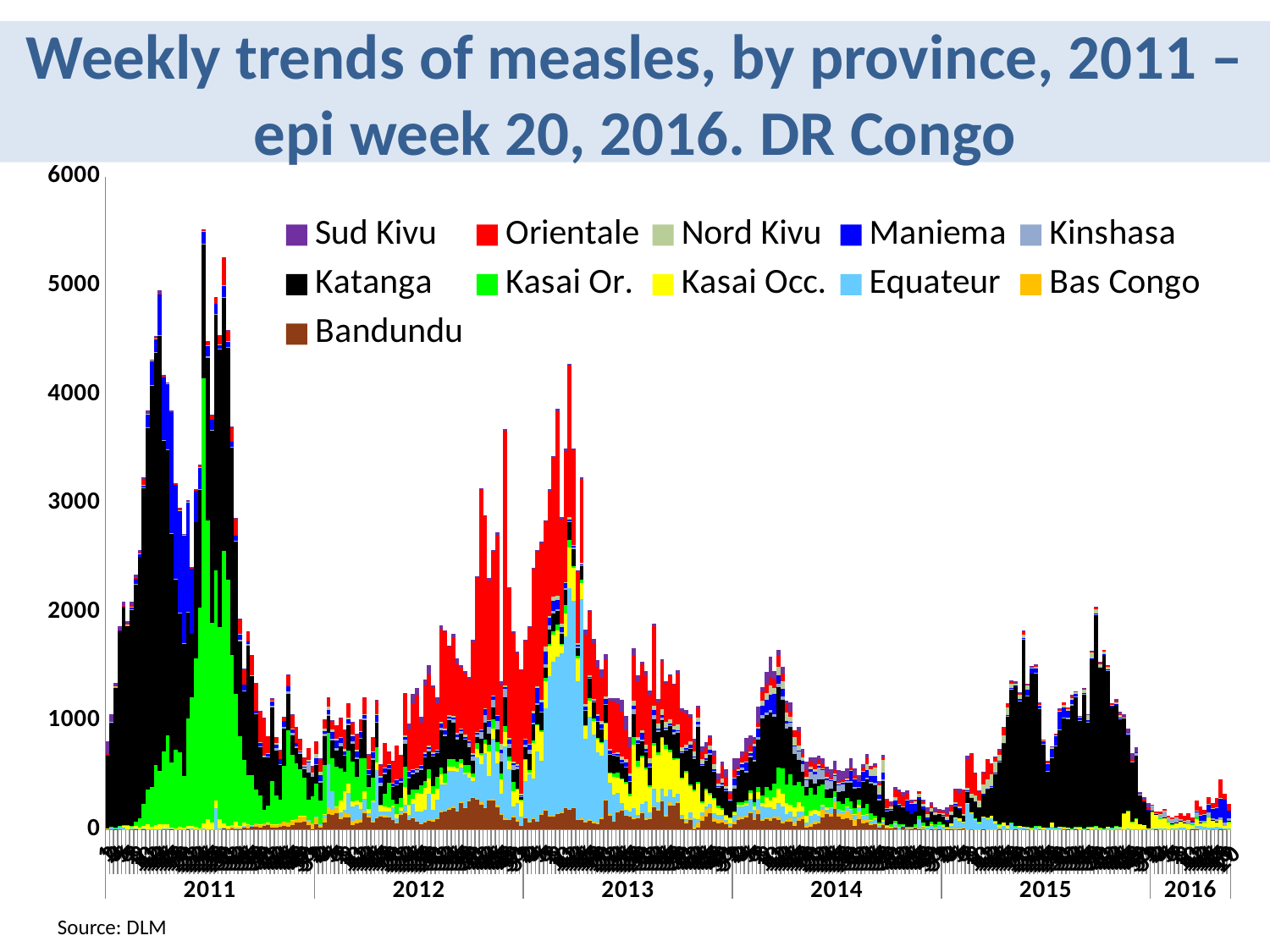
Are the weekly values in 2016 greater or less than 1000? less Is the highest weekly peak in 2013 greater or less than 5000? less Is the highest weekly peak in 2011 greater or less than 5000? greater Which province is shown in black in the legend? Katanga How many provinces (series) does the legend list? 11 Which province is shown in red in the legend? Orientale What kind of chart is shown on the slide? Stacked bar chart Which year on the x axis contains the highest weekly peak? 2011 Is the peak in 2011 higher or lower than the peak in 2015? higher How many year labels appear along the x axis? 6